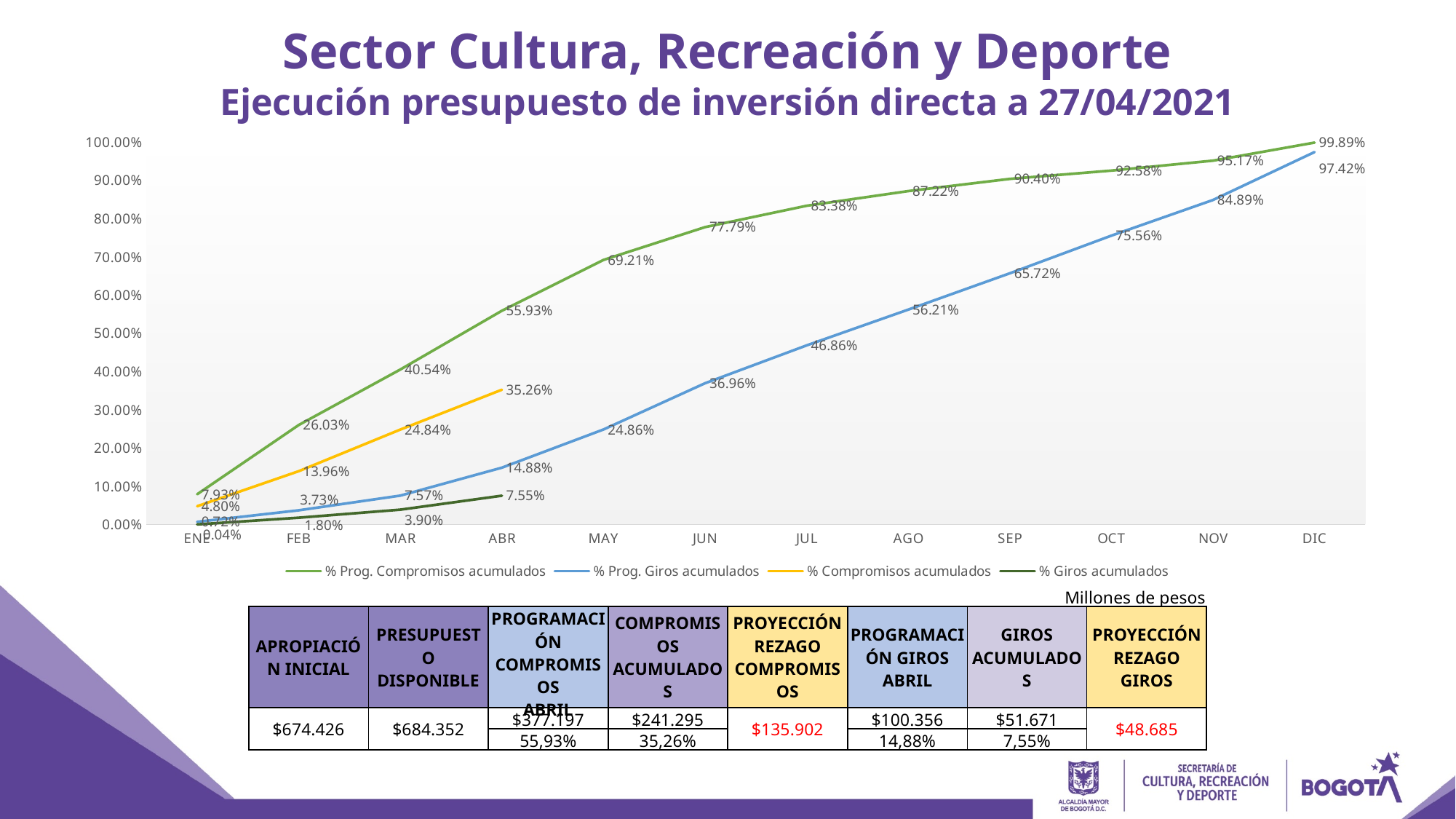
What is the value of % Giros acumulados in ABR? 7.55% What is the difference between % Prog. Compromisos acumulados and % Compromisos acumulados in ABR? 20.67 percentage points What is the value of % Prog. Compromisos acumulados in ABR? 55.93% What is the value of % Compromisos acumulados in ABR? 35.26% What is the value of % Prog. Giros acumulados in DIC? 97.42% Does % Prog. Compromisos acumulados rise or fall from ENE to DIC? Rise What kind of chart is shown on the slide? Line chart In JUN, which is larger: % Prog. Compromisos acumulados or % Prog. Giros acumulados? % Prog. Compromisos acumulados How many months are shown on the x axis? 12 What is the value of % Prog. Compromisos acumulados in DIC? 99.89% What is the value of % Prog. Giros acumulados in JUL? 46.86% How many series does the legend list? 4